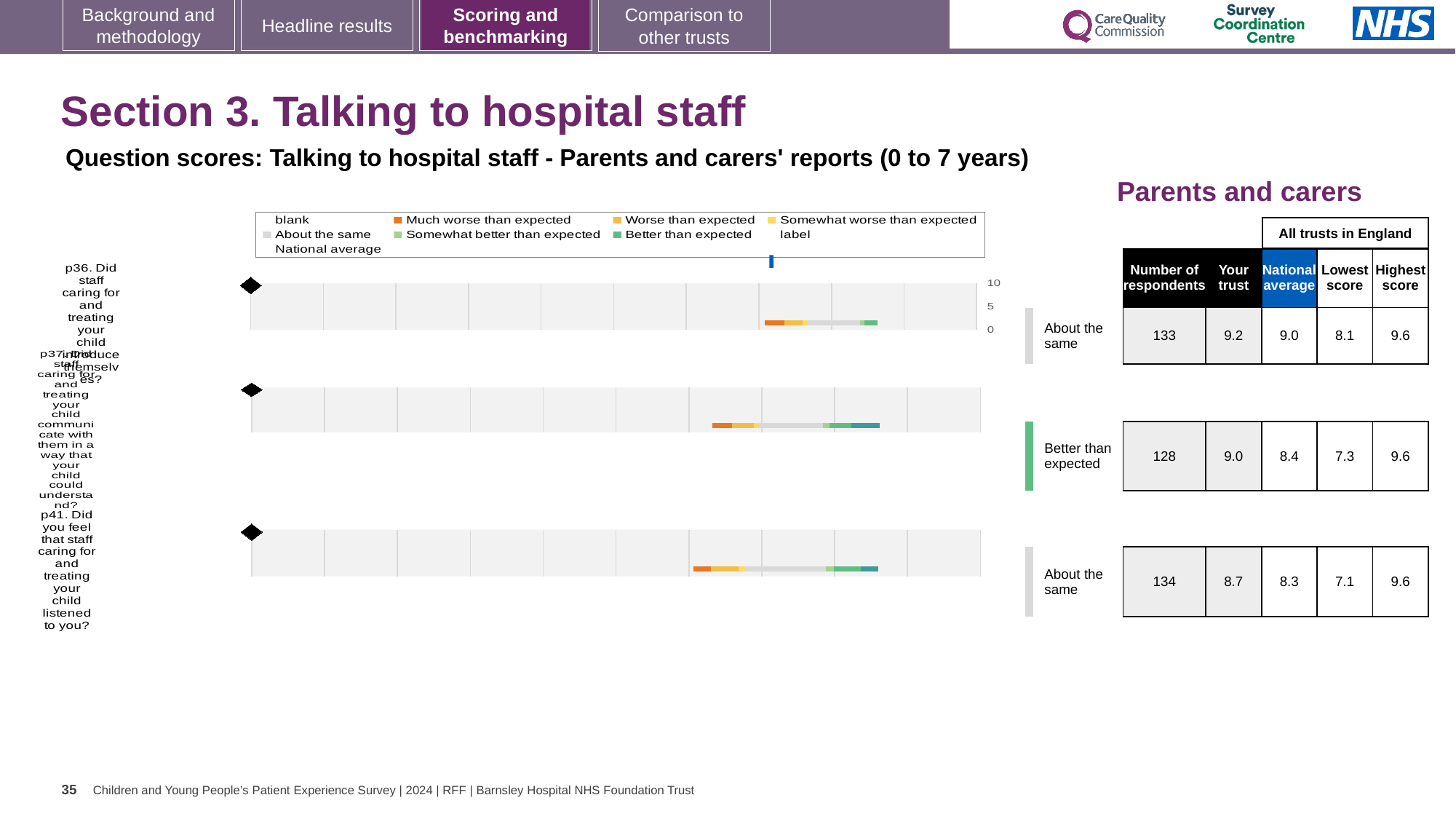
Which question has the highest 'Your trust' score? p36 How many respondents answered p41 (Did you feel that staff listened to you?)? 134 What is the national average for p37 (Did staff communicate with your child in a way they could understand?)? 8.4 Which benchmark category is p37 rated as? Better than expected Which question has the lowest 'Lowest score' across all trusts in England? p41 What is the highest value shown on the chart's axis? 10 How many entries does the chart legend list? 9 How many questions (categories) are plotted in the chart? 3 What is the 'Your trust' score for p36 (Did staff caring for and treating your child introduce themselves?)? 9.2 What is the difference between the 'Your trust' score and the national average for p36? 0.2 Which has the larger 'Your trust' score, p36 or p41? p36 What kind of chart is shown on the slide? bar chart